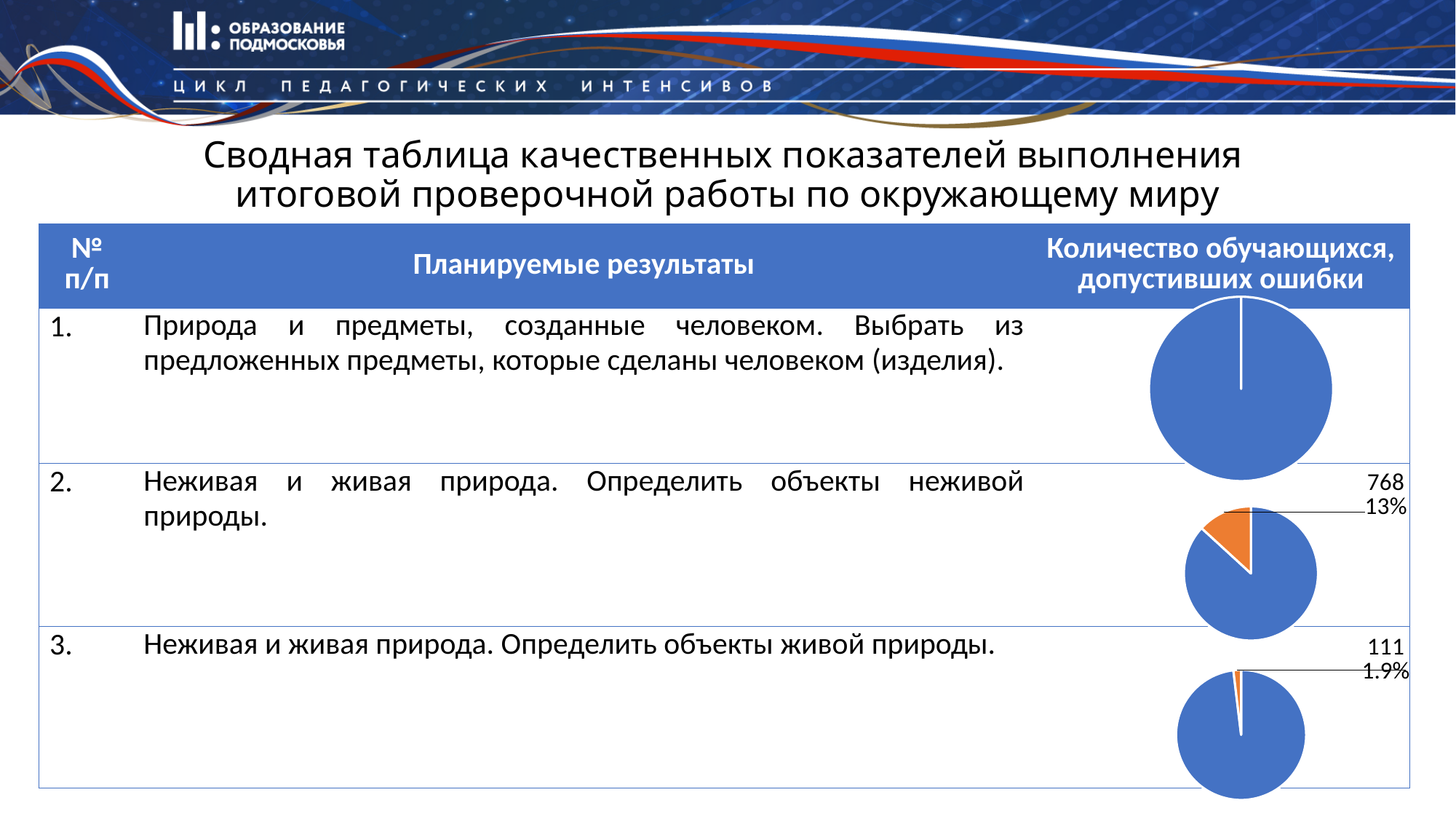
What is the difference between the labeled values of the orange slices in the row 2 and row 3 pie charts (768 and 111)? 657 In the pie chart for row 2, what percentage is printed for the orange slice? 13% What is the difference between the labeled percentages of the orange slices in the row 2 and row 3 pie charts (13% and 1.9%)? 11.1% What kind of chart is shown in the rightmost column of the table for row 2? pie chart In the pie chart for row 3 (Неживая и живая природа. Определить объекты живой природы), what number is printed next to the orange slice? 111 In the pie chart for row 3, what percentage is printed for the orange slice? 1.9% How many pie charts are shown on the slide? 3 Which of the three pie charts has the smallest labeled orange slice? row 3 In the pie chart for row 2 (Неживая и живая природа. Определить объекты неживой природы), what number is printed next to the orange slice? 768 What colour is the slice labeled 768 in the row 2 pie chart? orange Does the pie chart for row 1 show any orange slice? no Which row's pie chart has the larger orange slice, row 2 or row 3? row 2